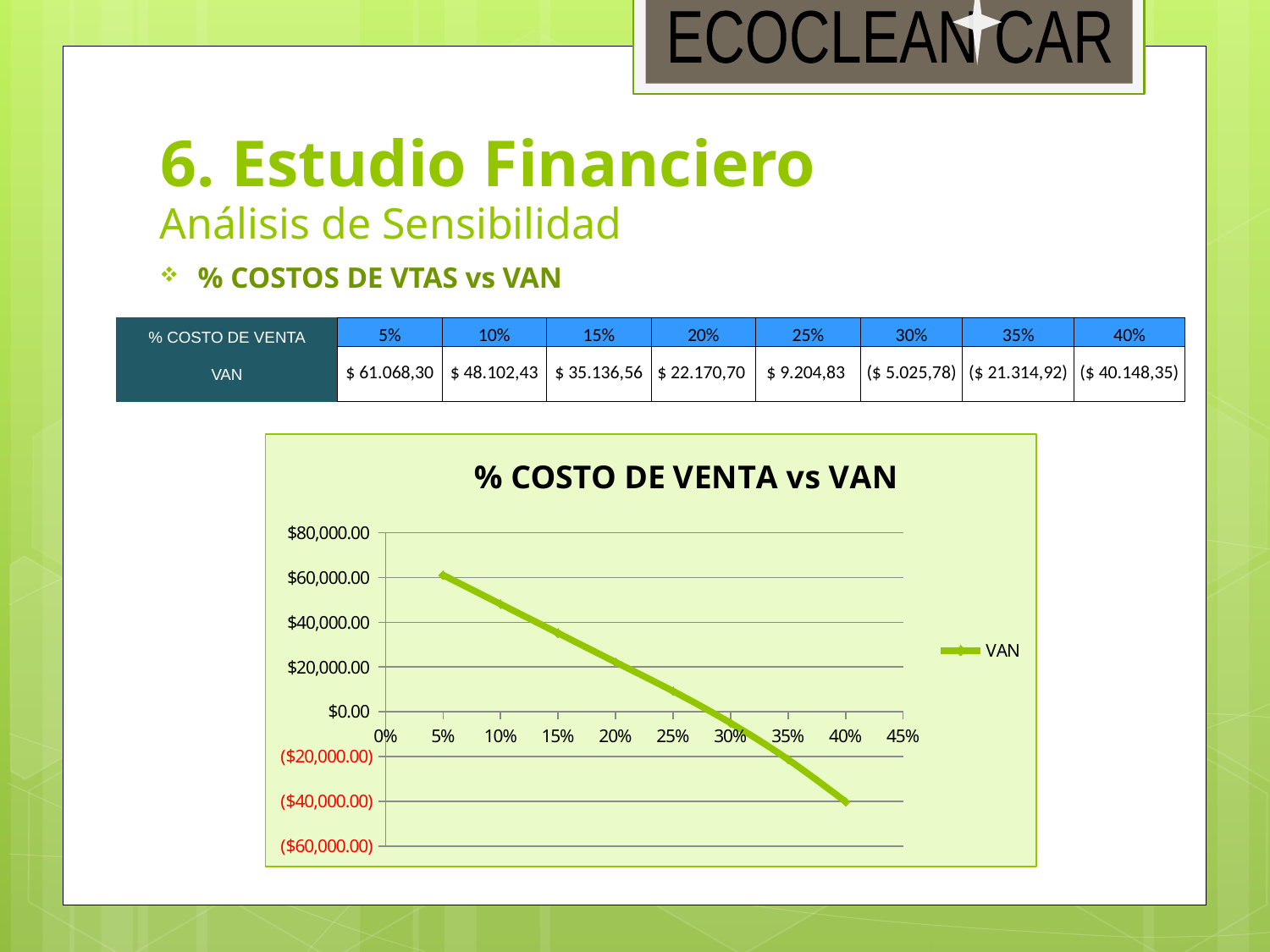
Which has a larger VAN, a cost of sales of 10% or 30%? 10% How many data points are plotted on the VAN line? 8 Does the VAN value rise or fall as % COSTO DE VENTA increases along the x axis? fall At which % COSTO DE VENTA is the VAN highest? 5% Is the VAN value at 40% greater or less than ($20,000.00)? less Is the VAN value at 5% greater or less than $40,000.00? greater According to the table, what is the VAN at a 20% cost of sales? $ 22.170,70 What is the name of the series shown in the chart legend? VAN At which % COSTO DE VENTA is the VAN lowest? 40% What is the title of the chart? % COSTO DE VENTA vs VAN How many series does the chart legend list? 1 What kind of chart is shown on the slide? line chart